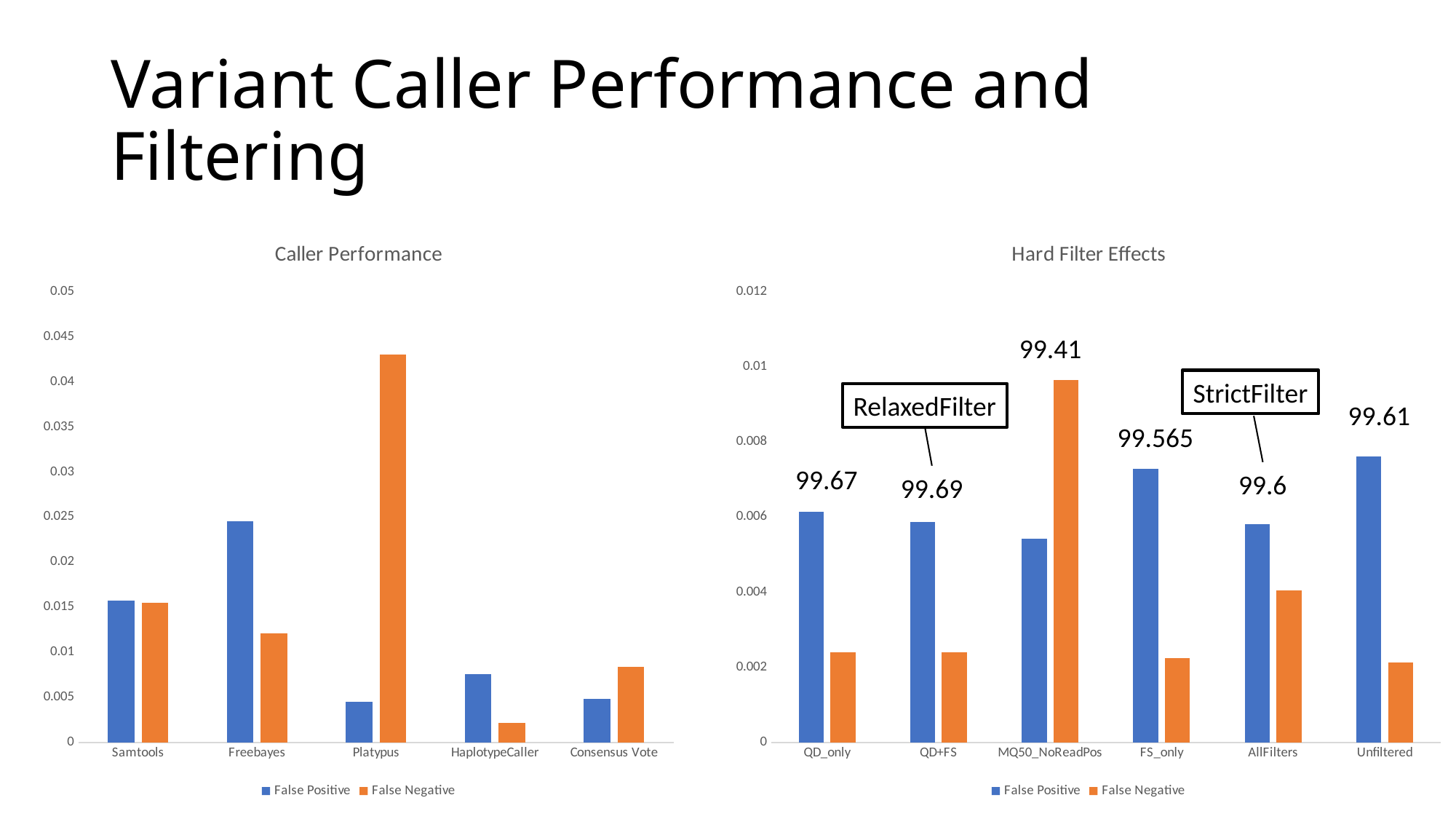
How many series does the legend of the Hard Filter Effects chart list? 2 In the Caller Performance chart, which caller has the highest False Negative value? Platypus In the Caller Performance chart, which is larger for Freebayes, False Positive or False Negative? False Positive In the Caller Performance chart, which caller has the highest False Positive value? Freebayes In the Caller Performance chart, is the False Negative value for Platypus greater or less than 0.04? greater How many callers are shown on the x axis of the Caller Performance chart? 5 In the Caller Performance chart, which caller has the lowest False Negative value? HaplotypeCaller In the Hard Filter Effects chart, which filter has the highest False Negative value? MQ50_NoReadPos In the Hard Filter Effects chart, what is the text in the box pointing to the QD+FS bars? RelaxedFilter What kind of chart is the Caller Performance chart? bar chart How many filter categories are shown on the x axis of the Hard Filter Effects chart? 6 In the Hard Filter Effects chart, is the False Positive value for FS_only greater or less than 0.006? greater